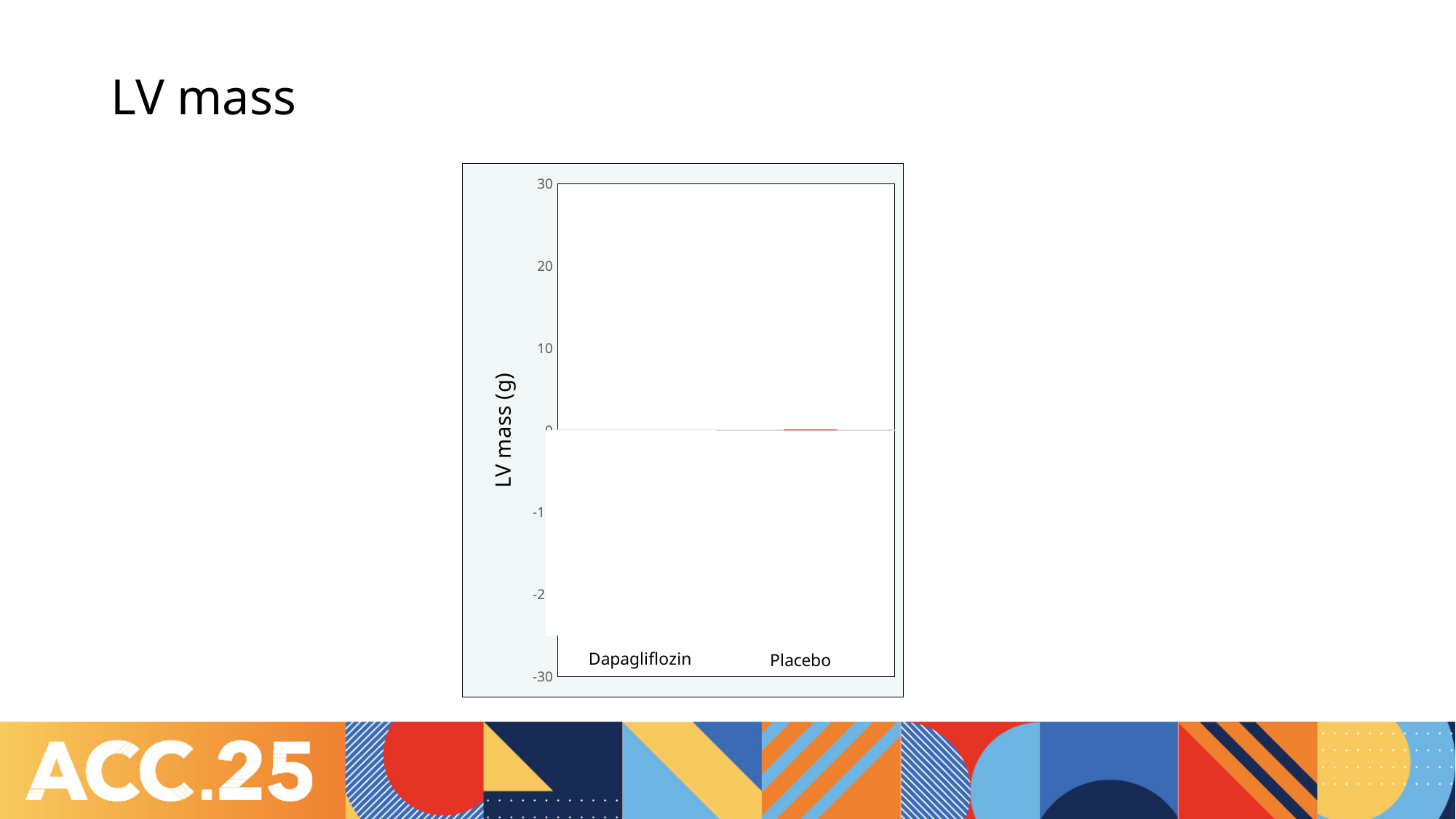
What is the lowest tick value shown on the y axis of the chart? -30 Is the value for Placebo greater or less than 10? less What kind of chart is shown on the slide? bar chart How many categories are shown on the x axis of the chart? 2 What is the label on the y axis of the chart? LV mass (g) What are the two categories labelled on the x axis of the chart? Dapagliflozin and Placebo What is the highest tick value shown on the y axis of the chart? 30